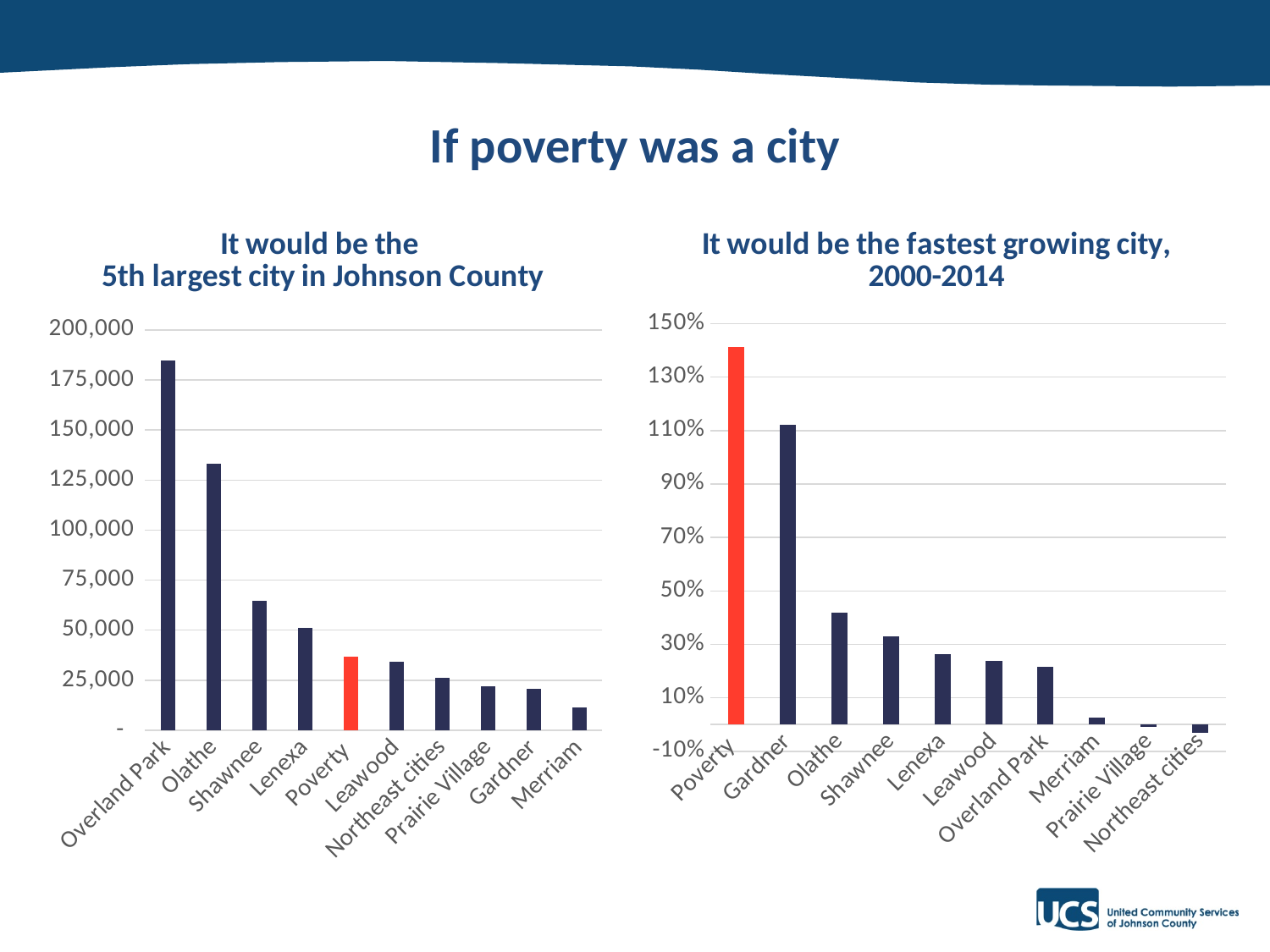
On the right chart (fastest growing city), is the value for Poverty greater or less than 130%? greater What type of chart is the right chart (fastest growing city)? bar chart On the left chart (5th largest city), is the value for Overland Park greater or less than 175,000? greater On the right chart (fastest growing city), which is larger, Gardner or Olathe? Gardner On the left chart (5th largest city), how many categories are shown on the x axis? 10 On the right chart (fastest growing city), which category has the highest value? Poverty On the right chart (fastest growing city), is the value for Overland Park greater or less than 30%? less On the left chart (5th largest city), which category has the highest value? Overland Park On the left chart (5th largest city), which category has the lowest value? Merriam On the left chart (5th largest city), which is larger, Olathe or Shawnee? Olathe